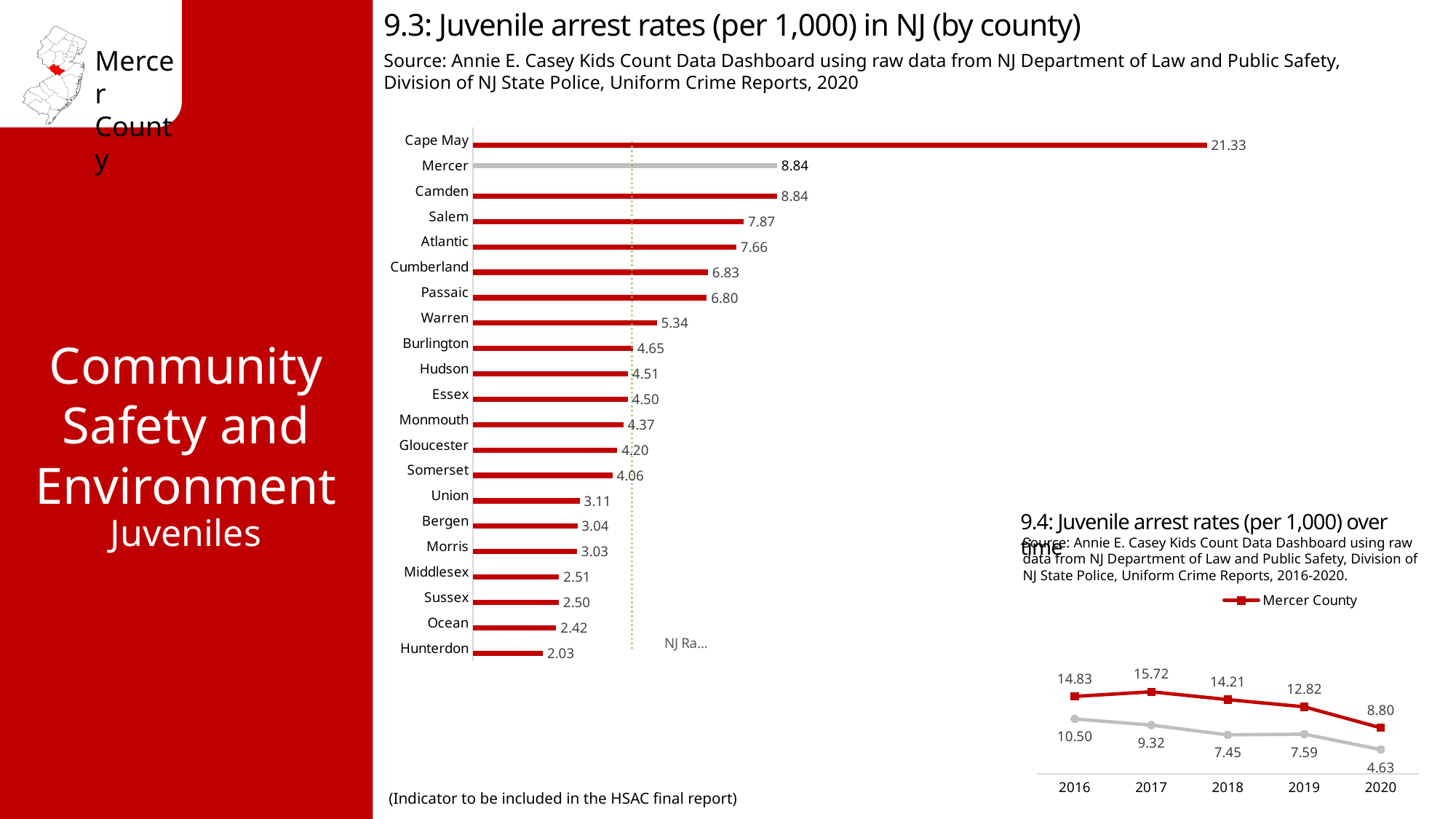
In the chart '9.3: Juvenile arrest rates (per 1,000) in NJ (by county)', what is the difference between the values for Cape May and Camden? 12.49 What kind of chart is '9.3: Juvenile arrest rates (per 1,000) in NJ (by county)'? Bar chart In the chart '9.3: Juvenile arrest rates (per 1,000) in NJ (by county)', which has a larger value, Passaic or Warren? Passaic In the chart '9.3: Juvenile arrest rates (per 1,000) in NJ (by county)', which county has the lowest value? Hunterdon In the chart '9.4: Juvenile arrest rates (per 1,000) over time', what is the Mercer County value for 2020? 8.80 In the chart '9.3: Juvenile arrest rates (per 1,000) in NJ (by county)', which county has the highest value? Cape May In the chart '9.4: Juvenile arrest rates (per 1,000) over time', what is the Mercer County value for 2017? 15.72 In the chart '9.4: Juvenile arrest rates (per 1,000) over time', what is the difference between the Mercer County values for 2016 and 2020? 6.03 How many counties are shown in the chart '9.3: Juvenile arrest rates (per 1,000) in NJ (by county)'? 21 In the chart '9.3: Juvenile arrest rates (per 1,000) in NJ (by county)', what is the value for Mercer? 8.84 In the chart '9.3: Juvenile arrest rates (per 1,000) in NJ (by county)', what is the value for Cape May? 21.33 In the chart '9.4: Juvenile arrest rates (per 1,000) over time', does the Mercer County value rise or fall from 2017 to 2020? Fall